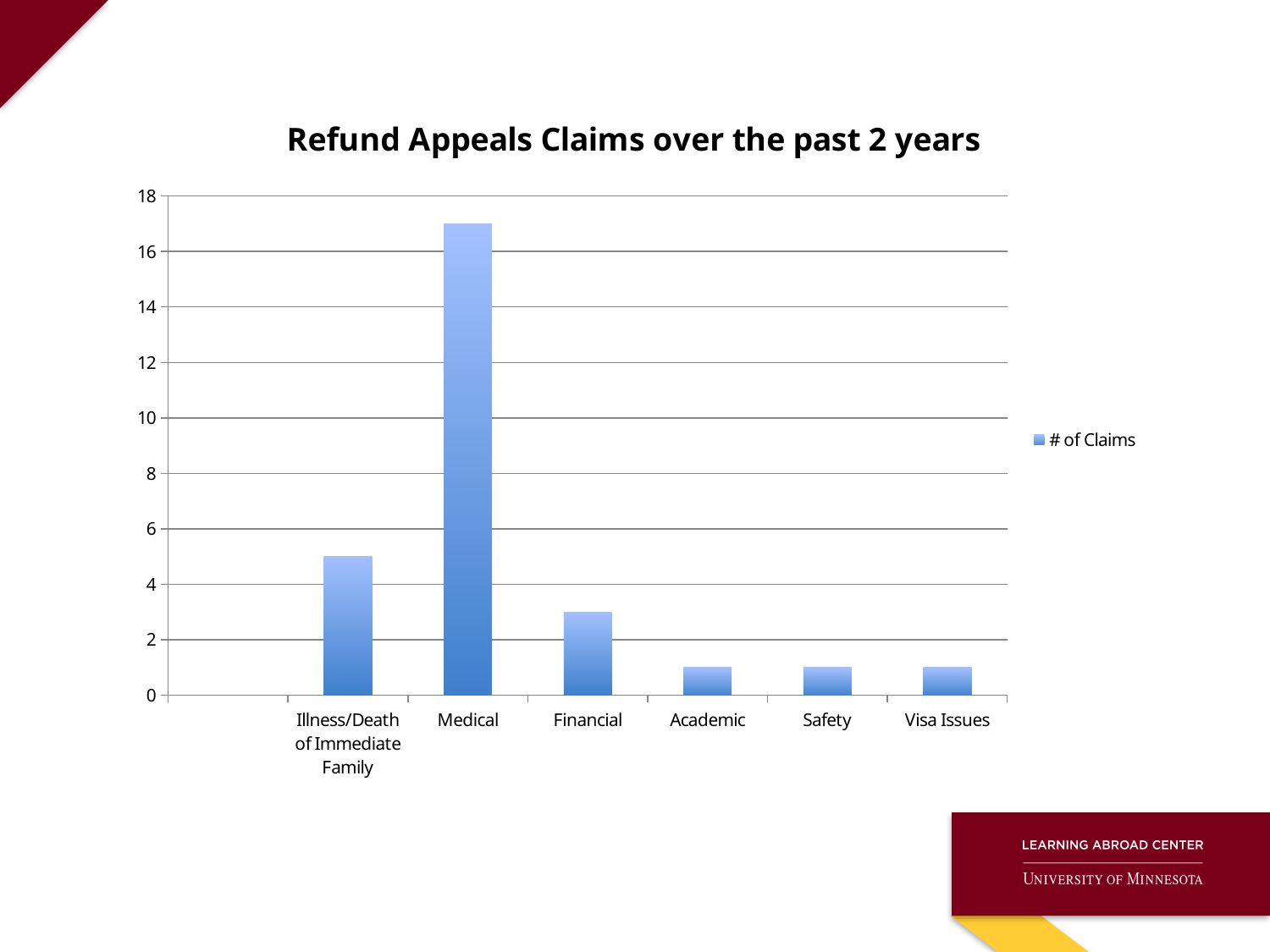
Which has more claims, Illness/Death of Immediate Family or Financial? Illness/Death of Immediate Family How many categories are shown on the x axis of the chart? 6 Is the value for Financial greater or less than 4? less Which category has the highest number of claims? Medical How many series does the legend list? 1 What is the name of the series shown in the legend? # of Claims What type of chart is shown on the slide? bar chart Is the value for Medical greater or less than 16? greater Is the value for Illness/Death of Immediate Family greater or less than 4? greater Which has more claims, Medical or Safety? Medical What is the title of the chart? Refund Appeals Claims over the past 2 years